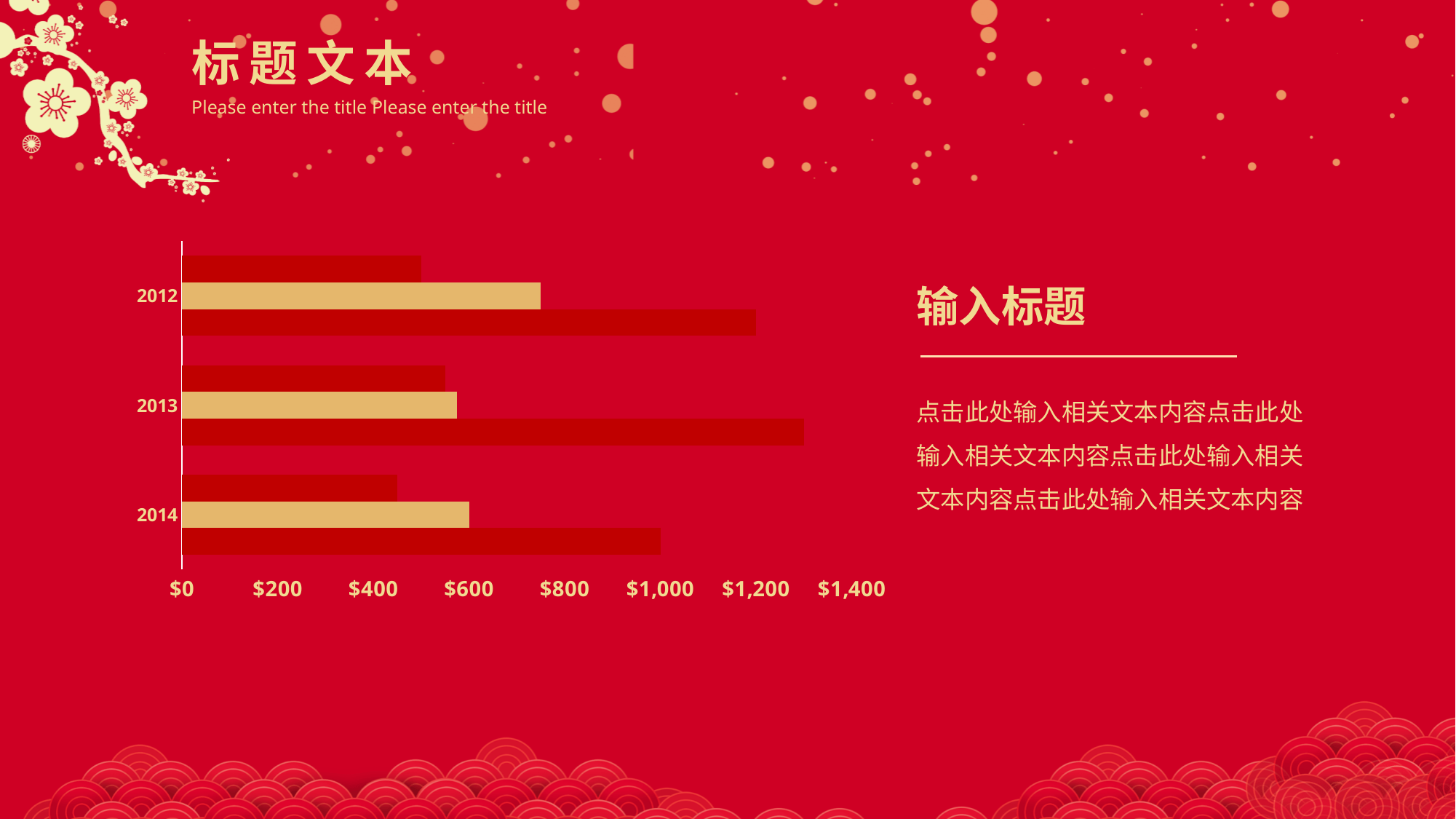
Which is longer, the top red bar for 2013 or the top red bar for 2014? 2013 Which year has the shortest dark red (bottom) bar? 2014 What is the highest value labelled on the horizontal axis of the chart? $1,400 What kind of chart is shown on the slide? bar chart Is the dark red (bottom) bar for 2012 greater or less than $1,000? greater Which year has the longest dark red (bottom) bar? 2013 Is the gold (middle) bar for 2012 greater or less than $600? greater Which is longer, the gold (middle) bar for 2012 or the gold (middle) bar for 2013? 2012 How many bars are drawn for each year in the chart? 3 Is the gold (middle) bar for 2014 greater or less than $800? less How many years are listed on the vertical axis of the chart? 3